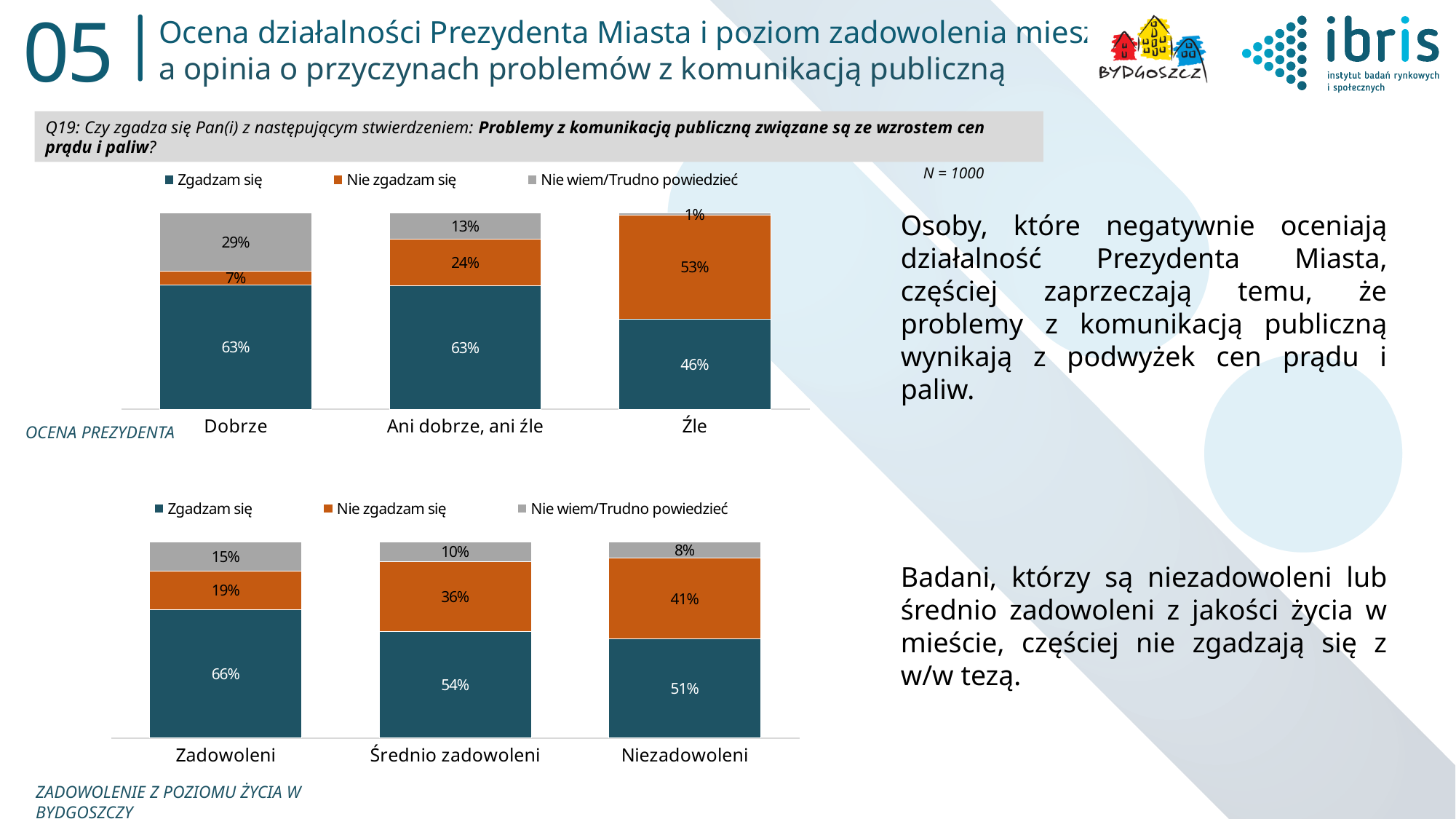
What type of chart is the top chart (OCENA PREZYDENTA)? Stacked bar chart How many series does the legend of the top chart (OCENA PREZYDENTA) list? 3 In the bottom chart (ZADOWOLENIE Z POZIOMU ŻYCIA W BYDGOSZCZY), what is the total of the stacked bar for "Niezadowoleni"? 100% In the bottom chart (ZADOWOLENIE Z POZIOMU ŻYCIA W BYDGOSZCZY), what is the value of "Zgadzam się" for "Średnio zadowoleni"? 54% In the bottom chart (ZADOWOLENIE Z POZIOMU ŻYCIA W BYDGOSZCZY), which category has the highest "Nie zgadzam się" value? Niezadowoleni In the top chart (OCENA PREZYDENTA), which is larger: "Nie zgadzam się" for "Ani dobrze, ani źle" or "Nie zgadzam się" for "Dobrze"? Ani dobrze, ani źle In the top chart (OCENA PREZYDENTA), what is the value of "Nie zgadzam się" for the "Źle" category? 53% In the top chart (OCENA PREZYDENTA), which category has the lowest "Zgadzam się" value? Źle In the top chart (OCENA PREZYDENTA), what is the value of "Nie wiem/Trudno powiedzieć" for the "Dobrze" category? 29% In the top chart (OCENA PREZYDENTA), which colour represents "Nie zgadzam się"? Orange How many categories are shown on the x axis of the bottom chart (ZADOWOLENIE Z POZIOMU ŻYCIA W BYDGOSZCZY)? 3 In the bottom chart (ZADOWOLENIE Z POZIOMU ŻYCIA W BYDGOSZCZY), what is the difference between the "Zgadzam się" values for "Zadowoleni" and "Niezadowoleni"? 15 percentage points